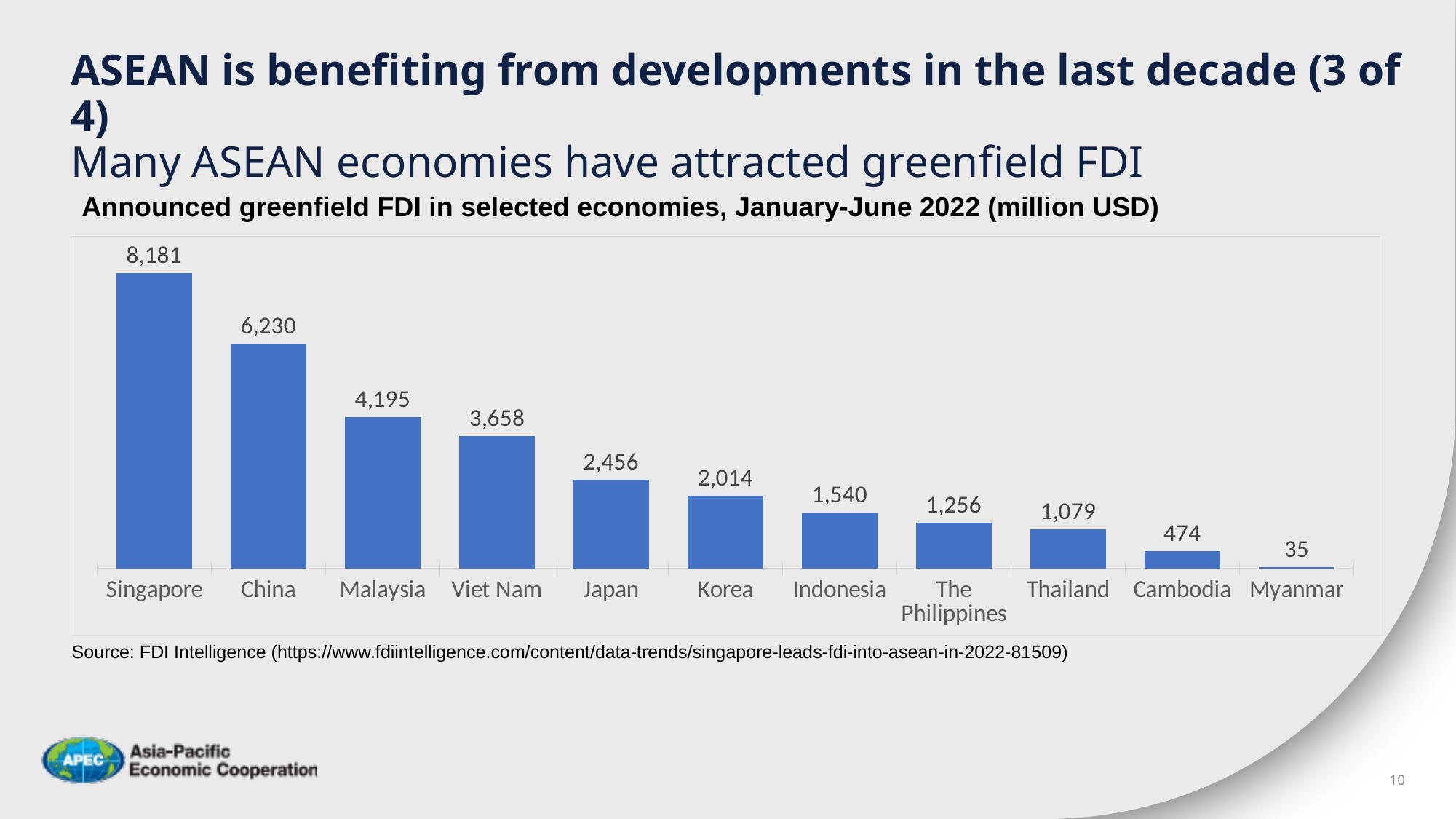
Which economy has the lowest announced greenfield FDI? Myanmar What is the announced greenfield FDI value for Viet Nam? 3,658 What is the announced greenfield FDI value for Singapore? 8,181 Which economy has the highest announced greenfield FDI? Singapore Do the values rise or fall moving from left to right along the x axis? Fall What kind of chart is shown on the slide? Bar chart What is the announced greenfield FDI value for The Philippines? 1,256 How many economies are shown in the chart? 11 Which has a larger announced greenfield FDI value, Japan or Korea? Japan What is the difference between the values for Malaysia and Viet Nam? 537 What is the difference between the values for Singapore and China? 1,951 Which has a larger announced greenfield FDI value, Thailand or Cambodia? Thailand